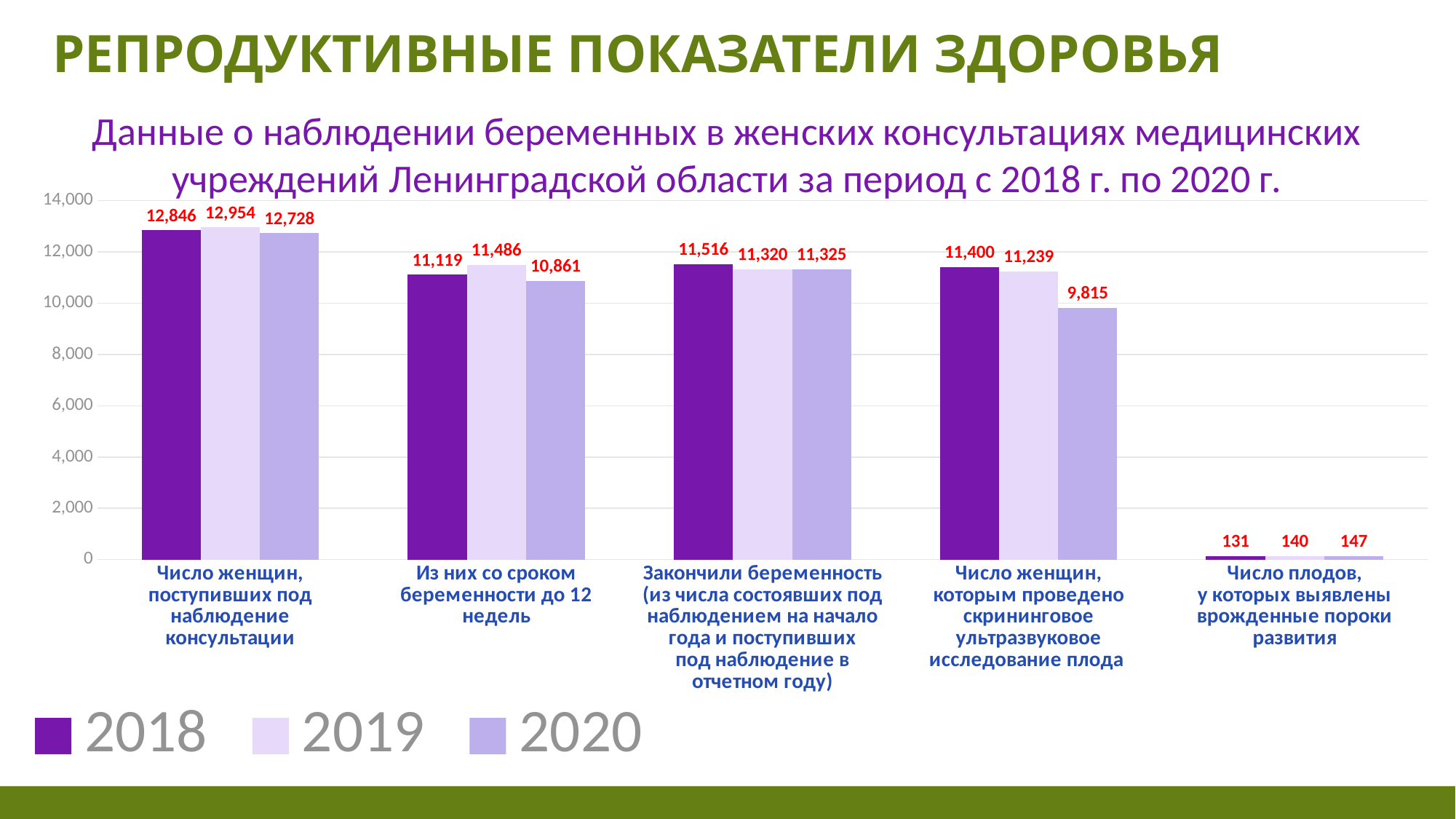
Do the values for "Число плодов, у которых выявлены врожденные пороки развития" rise or fall from 2018 to 2020? rise Which category has the lowest values across all three years? Число плодов, у которых выявлены врожденные пороки развития What kind of chart is shown on the slide? bar chart How many categories are shown on the x axis of the chart? 5 What is the difference between the 2018 and 2020 values in the category "Число женщин, которым проведено скрининговое ультразвуковое исследование плода"? 1,585 What is the value for 2018 in the category "Число плодов, у которых выявлены врожденные пороки развития"? 131 Is the 2020 value for "Число женщин, которым проведено скрининговое ультразвуковое исследование плода" greater or less than 10,000? less What is the value for 2020 in the category "Число женщин, которым проведено скрининговое ультразвуковое исследование плода"? 9,815 Which year has the highest value in the category "Из них со сроком беременности до 12 недель"? 2019 How many series does the legend list? 3 What is the value for 2019 in the category "Число женщин, поступивших под наблюдение консультации"? 12,954 Which is larger: the 2018 value or the 2020 value for "Из них со сроком беременности до 12 недель"? 2018